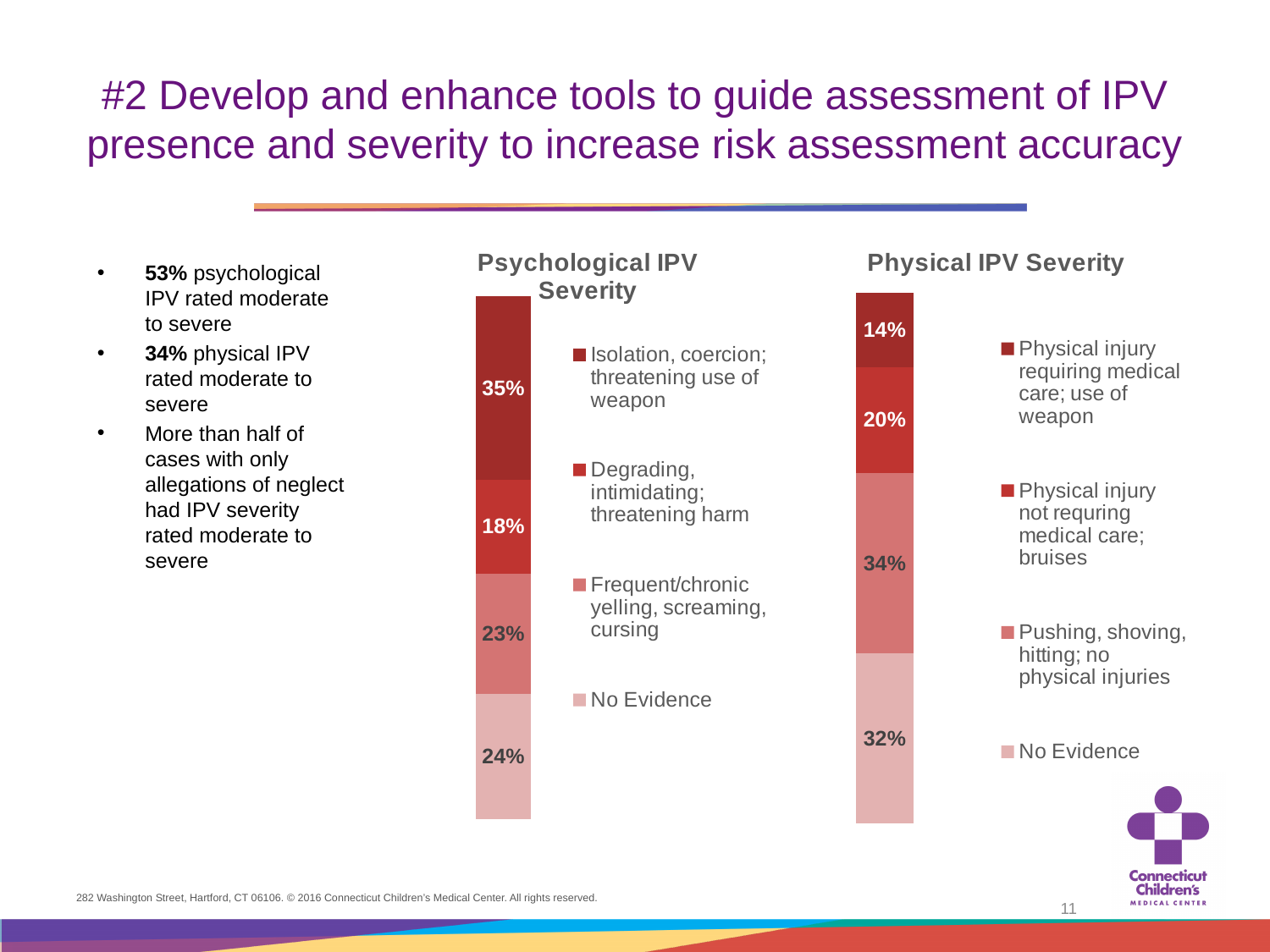
In the Physical IPV Severity chart, what percentage is shown for 'Pushing, shoving, hitting; no physical injuries'? 34% In the Psychological IPV Severity chart, which segment has the largest percentage? Isolation, coercion; threatening use of weapon In the Physical IPV Severity chart, what percentage is shown for 'Physical injury requiring medical care; use of weapon'? 14% How many entries does the legend of the Psychological IPV Severity chart list? 4 In the Physical IPV Severity chart, which is larger: 'Pushing, shoving, hitting; no physical injuries' or 'No Evidence'? Pushing, shoving, hitting; no physical injuries In the Psychological IPV Severity chart, what percentage is shown for the 'Isolation, coercion; threatening use of weapon' segment? 35% In the Physical IPV Severity chart, which segment has the smallest percentage? Physical injury requiring medical care; use of weapon In the Psychological IPV Severity chart, what is the difference between the 'Isolation, coercion; threatening use of weapon' segment and the 'Degrading, intimidating; threatening harm' segment? 17% In the Physical IPV Severity chart, what is the combined percentage of the two 'Physical injury' segments? 34% In the Psychological IPV Severity chart, what percentage is shown for 'No Evidence'? 24% How many segments make up the bar in the Physical IPV Severity chart? 4 What type of chart is the Psychological IPV Severity chart? Stacked bar chart